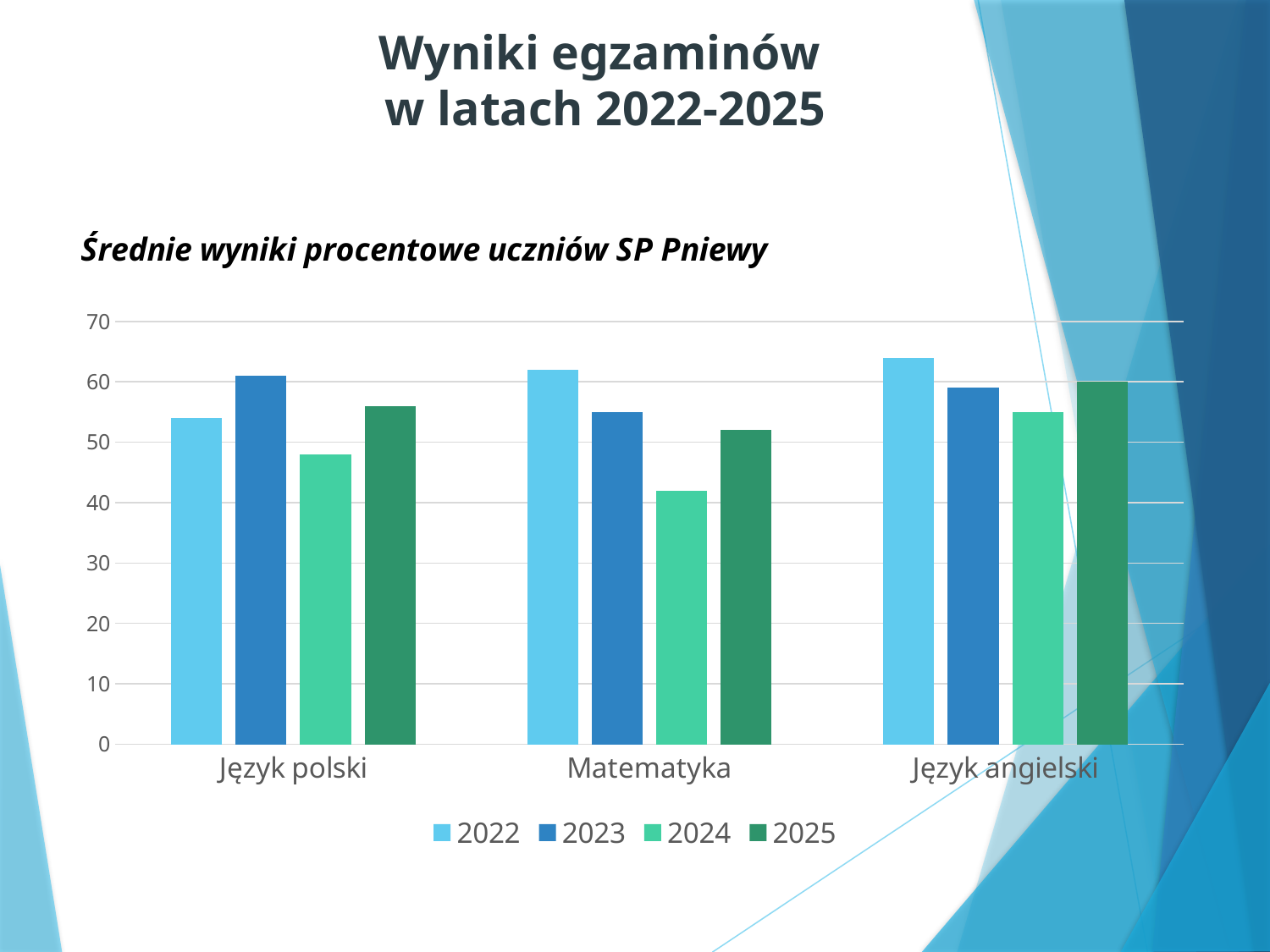
Is the value for Matematyka in 2024 greater or less than 50? less Which is larger for Matematyka: the value for 2022 or the value for 2023? 2022 What is the subtitle printed above the chart? Średnie wyniki procentowe uczniów SP Pniewy Which year has the highest value for Matematyka? 2022 Which year has the highest value for Język polski? 2023 Which year has the lowest value for Matematyka? 2024 What kind of chart is shown on the slide? bar chart Is the value for Język angielski in 2022 greater or less than 60? greater How many subject categories are shown on the x axis? 3 Which year has the lowest value for Język polski? 2024 Which year has the lowest value for Język angielski? 2024 How many series does the legend list? 4